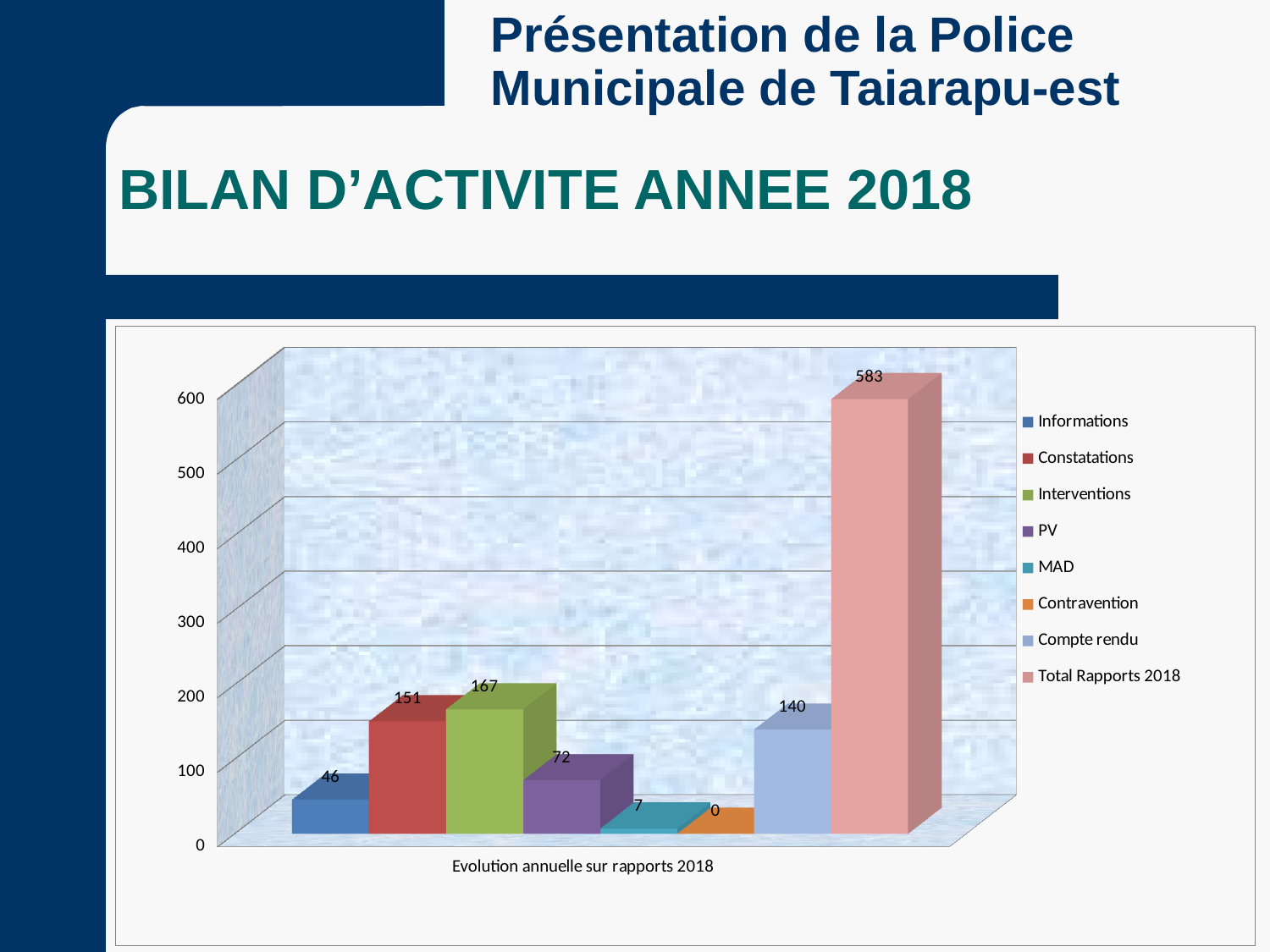
What is the value for Compte rendu? 140 How many series does the legend list? 8 What is the value for Contravention? 0 Which is larger, the value for Interventions or the value for Compte rendu? Interventions Which series has the lowest value? Contravention Which series has the highest value? Total Rapports 2018 What is the difference between the values for Constatations and PV? 79 What is the value for Informations? 46 Is the value for Total Rapports 2018 greater or less than 500? greater What is the value for Interventions? 167 What kind of chart is shown on the slide? bar chart What is the category label shown below the bars on the x axis? Evolution annuelle sur rapports 2018